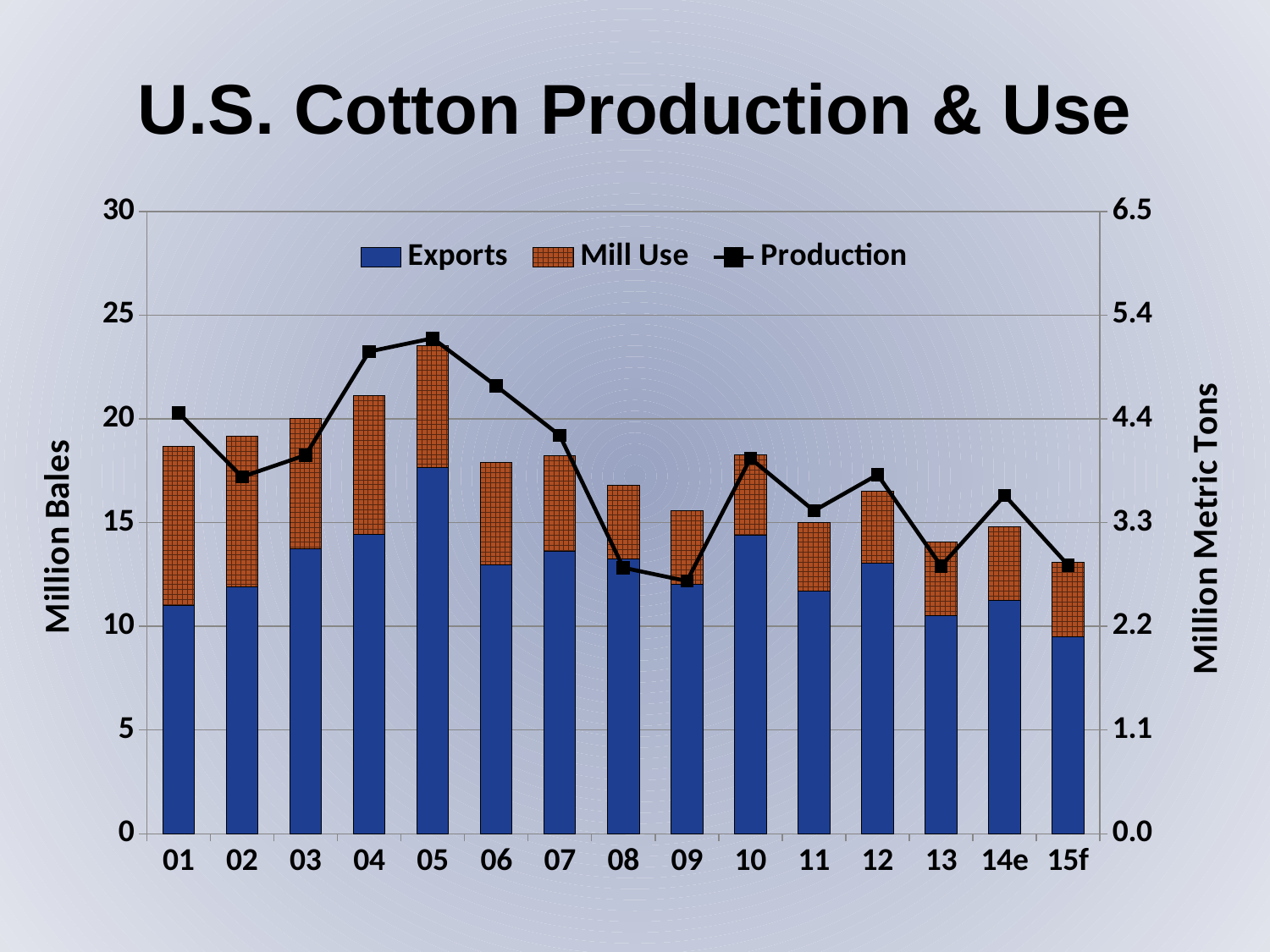
What is the title of the chart? U.S. Cotton Production & Use In which year does the Production line reach its highest point? 05 What is the label of the right-hand vertical axis? Million Metric Tons In which year is the total stacked bar (Exports plus Mill Use) the shortest? 15f Does the Production line rise or fall from 05 to 09? fall Is the Production value for 09 greater or less than 3.3 million metric tons? less Is the Exports value for 05 greater or less than 15 million bales? greater What kind of chart is shown on the slide? Stacked bar chart with a line Which year has the larger Exports value, 01 or 05? 05 In which year is the Exports bar segment the tallest? 05 How many year categories are shown on the x axis? 15 How many series does the legend list? 3